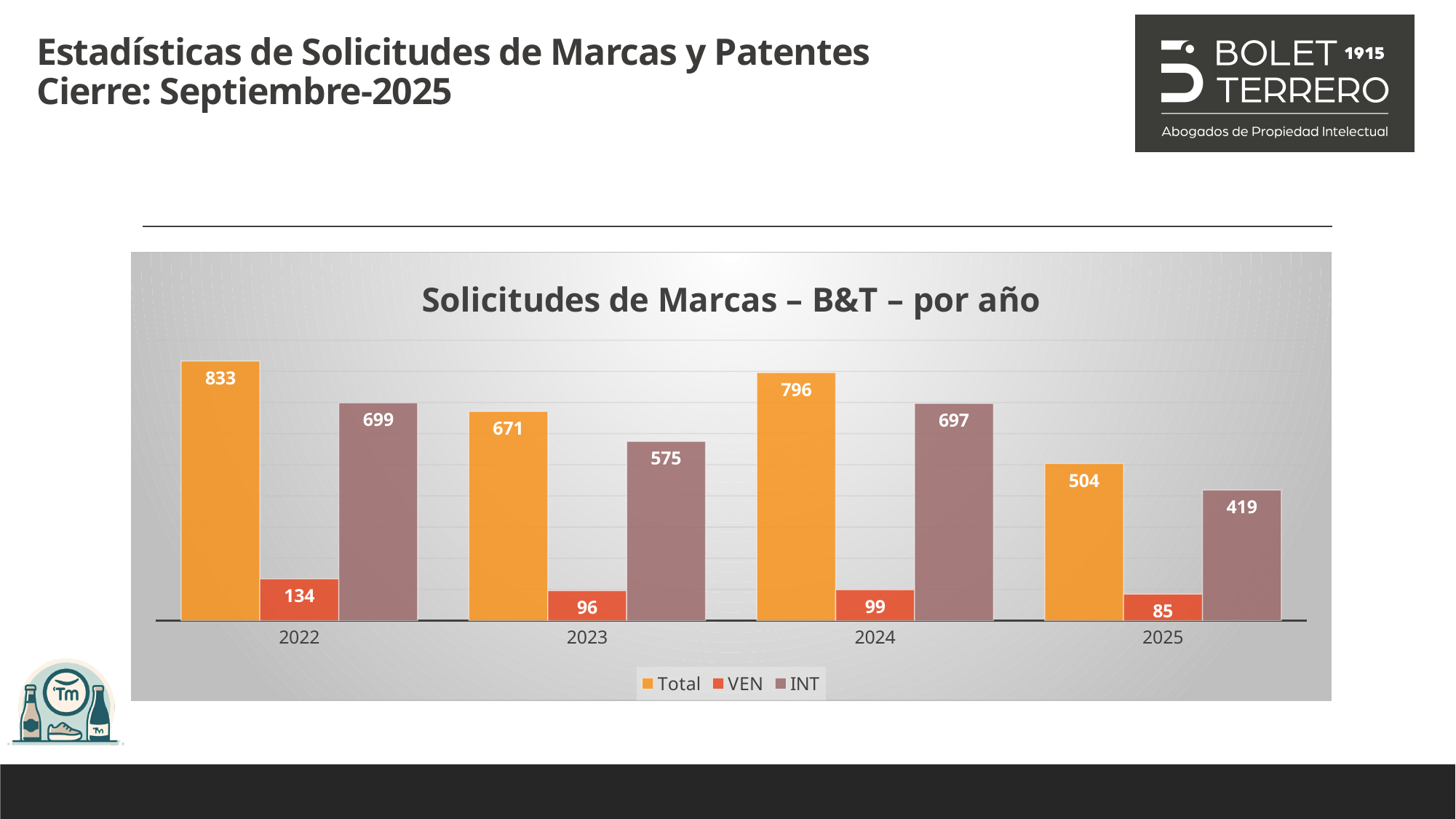
How many years are shown on the x axis? 4 Which year has the lowest VEN value? 2025 What is the difference between the INT values for 2024 and 2023? 122 Which is larger, the INT value for 2022 or the INT value for 2024? 2022 What is the difference between the Total values for 2022 and 2025? 329 What kind of chart is shown? Bar chart What is the Total value for 2022? 833 What is the title of the chart? Solicitudes de Marcas – B&T – por año What is the VEN value for 2024? 99 Which year has the highest Total value? 2022 How many series does the legend list? 3 What is the INT value for 2025? 419